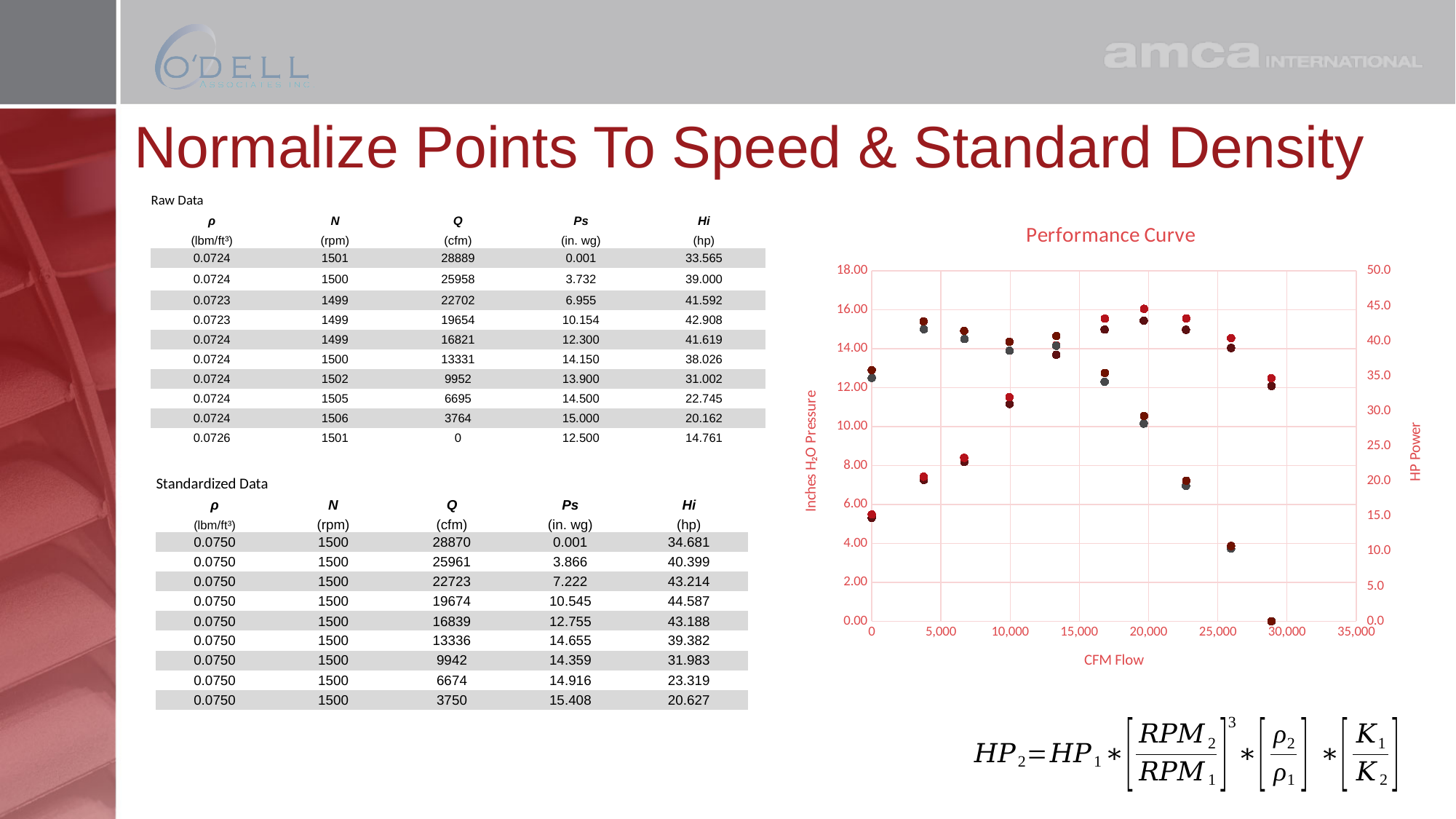
What is the title of the chart on the slide? Performance Curve In the Performance Curve chart, is the highest plotted point near CFM Flow 5,000 higher or lower than the highest plotted point near CFM Flow 29,000? higher In the Performance Curve chart, at CFM Flow 0, is the lowest plotted point greater or less than 8.00 on the Inches H2O Pressure axis? less In the Performance Curve chart, near CFM Flow 10,000, is the lowest plotted point greater or less than 10.00 on the Inches H2O Pressure axis? greater What is the title of the horizontal axis of the Performance Curve chart? CFM Flow In the Performance Curve chart, near CFM Flow 26,000, is the lowest plotted point greater or less than 6.00 on the Inches H2O Pressure axis? less In the Performance Curve chart, how many distinct CFM Flow positions have plotted points? 10 In the Performance Curve chart, do the lowest plotted points rise or fall as CFM Flow increases from 20,000 to 30,000? fall What kind of chart is the Performance Curve chart? scatter chart